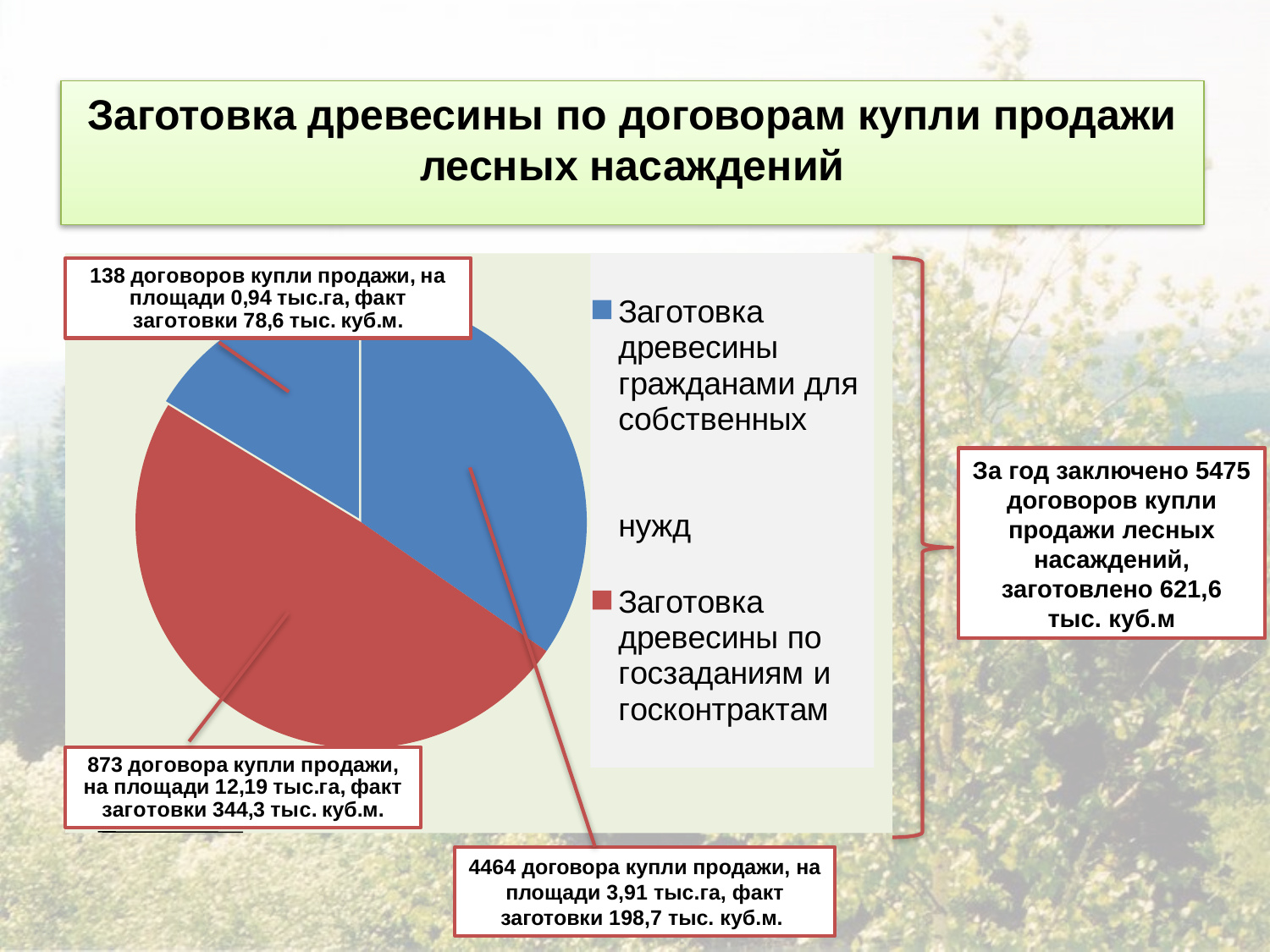
What kind of chart is shown on the slide? pie chart How many entries does the legend of the pie chart list? 2 Which colour represents 'Заготовка древесины по госзаданиям и госконтрактам' in the pie chart? red How many slices does the pie chart have? 3 What is the difference between the number of contracts in the 4464-contract callout and the 138-contract callout? 4326 How many contracts are reported in the callout for the red slice (заготовка древесины по госзаданиям и госконтрактам)? 873 договора Which callout reports the largest actual harvest volume? 873 договора (344,3 тыс. куб.м) According to the slide, how many purchase-and-sale contracts were concluded in total for the year? 5475 What total volume of timber was harvested for the year according to the slide? 621,6 тыс. куб.м What actual harvest volume is given in the callout for the red slice of the pie chart? 344,3 тыс. куб.м What is the smallest number of contracts reported in any callout on the pie chart? 138 What area is given in the callout for the red slice of the pie chart? 12,19 тыс.га